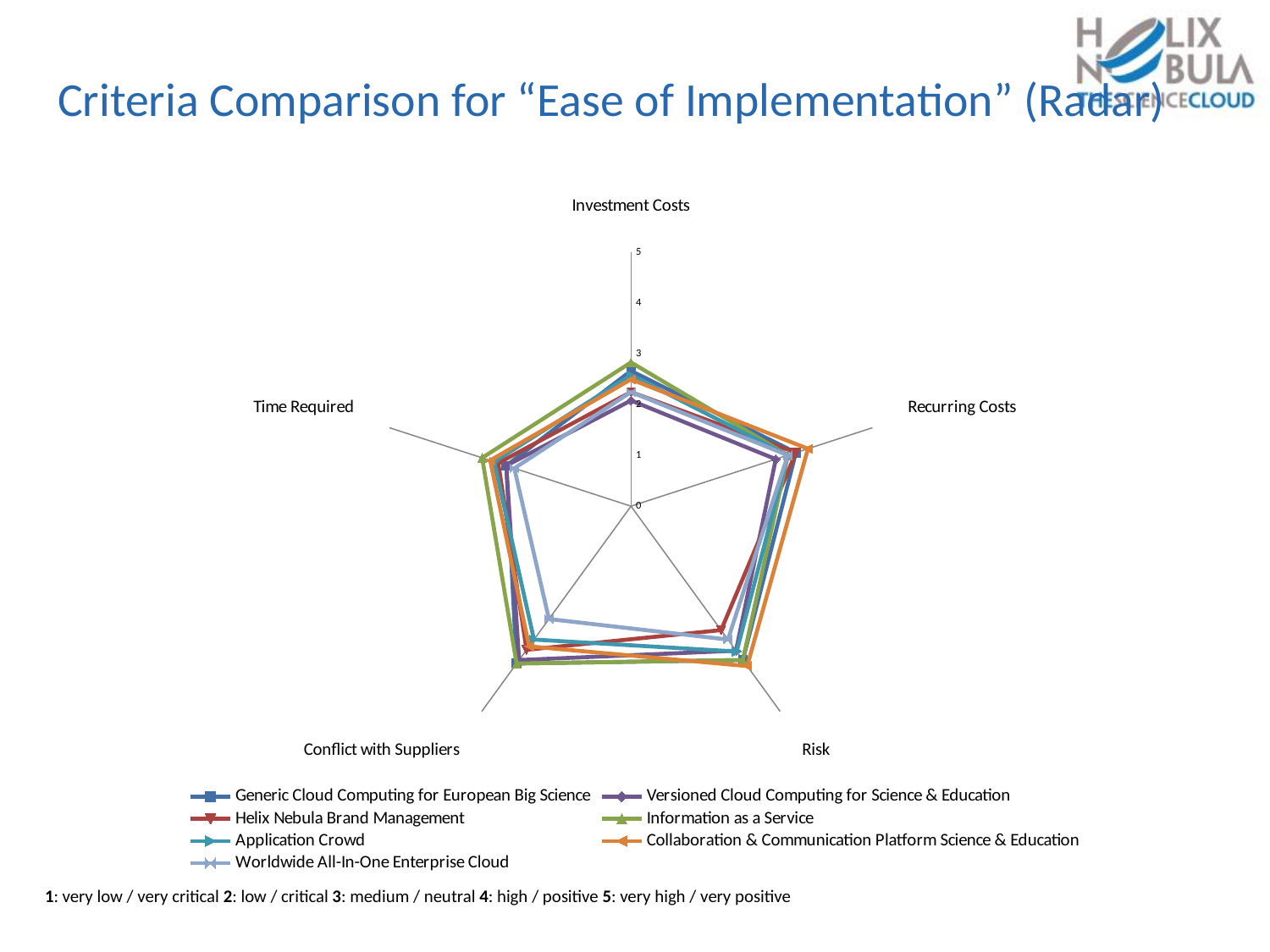
On Conflict with Suppliers, which is larger: Information as a Service or Worldwide All-In-One Enterprise Cloud? Information as a Service How many criteria (axes) does the radar chart have? 5 How many series does the legend list? 7 Which series has the highest value for Recurring Costs? Collaboration & Communication Platform Science & Education What kind of chart is shown on the slide? Radar chart Which series has the lowest value for Risk? Helix Nebula Brand Management Is the value for Versioned Cloud Computing for Science & Education on Investment Costs greater or less than 3? less What is the maximum value shown on the radar chart's axis scale? 5 Which series has the lowest value for Conflict with Suppliers? Worldwide All-In-One Enterprise Cloud Is the value for Collaboration & Communication Platform Science & Education on Recurring Costs greater or less than 3? greater What is the title of the chart on the slide? Criteria Comparison for "Ease of Implementation" (Radar) Is the value for Information as a Service on Risk greater or less than 3? greater